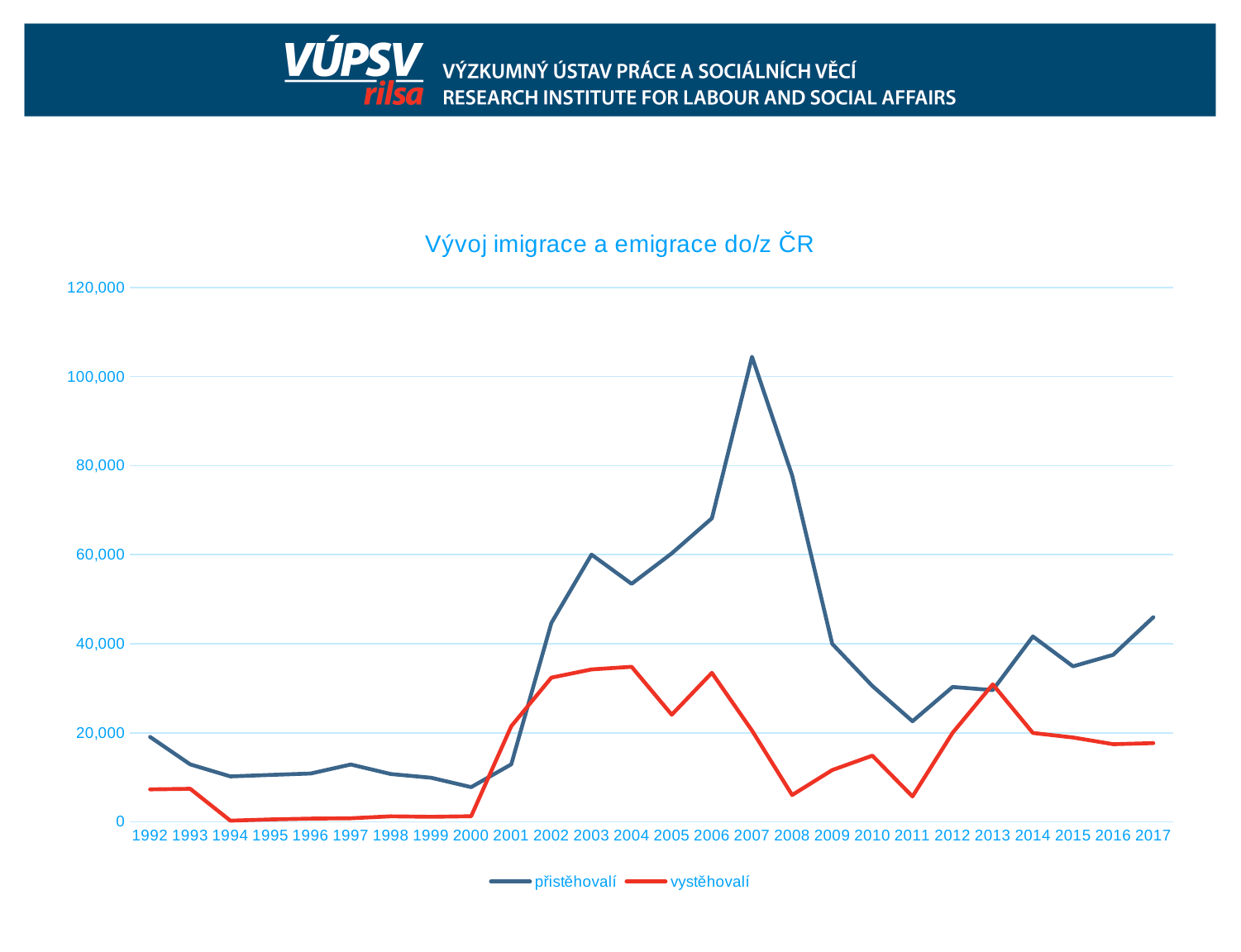
In which year does the přistěhovalí series reach its lowest value? 2000 Which series has the larger value in 2001, přistěhovalí or vystěhovalí? vystěhovalí Which series has the larger value in 2008, přistěhovalí or vystěhovalí? přistěhovalí Is the value for přistěhovalí in 2003 greater or less than 50,000? greater Does the přistěhovalí series rise or fall from 2007 to 2011? fall Is the value for vystěhovalí in 2008 greater or less than 10,000? less How many years are shown on the x axis? 26 What is the title of the chart? Vývoj imigrace a emigrace do/z ČR In which year does the přistěhovalí series reach its highest value? 2007 How many series does the legend list? 2 Is the value for přistěhovalí in 2007 greater or less than 100,000? greater What kind of chart is shown on the slide? line chart